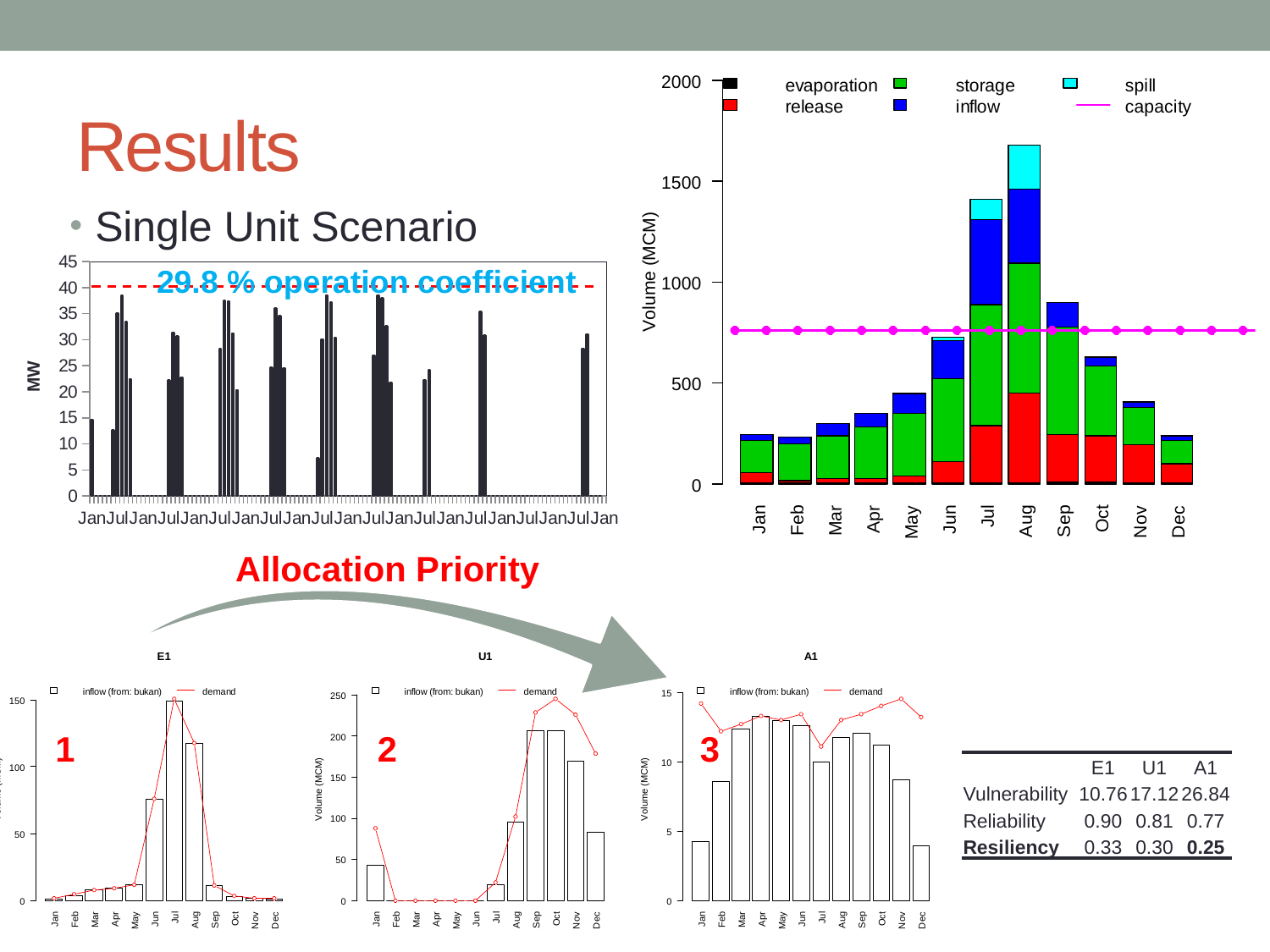
In the top-right stacked bar chart, which month has the tallest stacked bar? Aug In the bottom chart titled E1, is the inflow bar for Jul greater or less than 100? greater What kind of chart is the top-right chart with the Volume (MCM) axis? stacked bar chart In the top-right stacked bar chart, how many months are shown on the x axis? 12 In the top-left MW bar chart, at what value on the y axis is the red dashed line drawn? 40 In the top-right stacked bar chart, how many entries does the legend list? 6 In the top-right stacked bar chart, is the total for Jan greater or less than 500? less In the bottom chart titled E1, which month has the tallest inflow bar? Jul What is the y-axis label of the top-right stacked bar chart? Volume (MCM) In the top-right stacked bar chart, is the total for Jul greater or less than 1000? greater In the top-right stacked bar chart, which stacked bar is taller, Jul or Sep? Jul